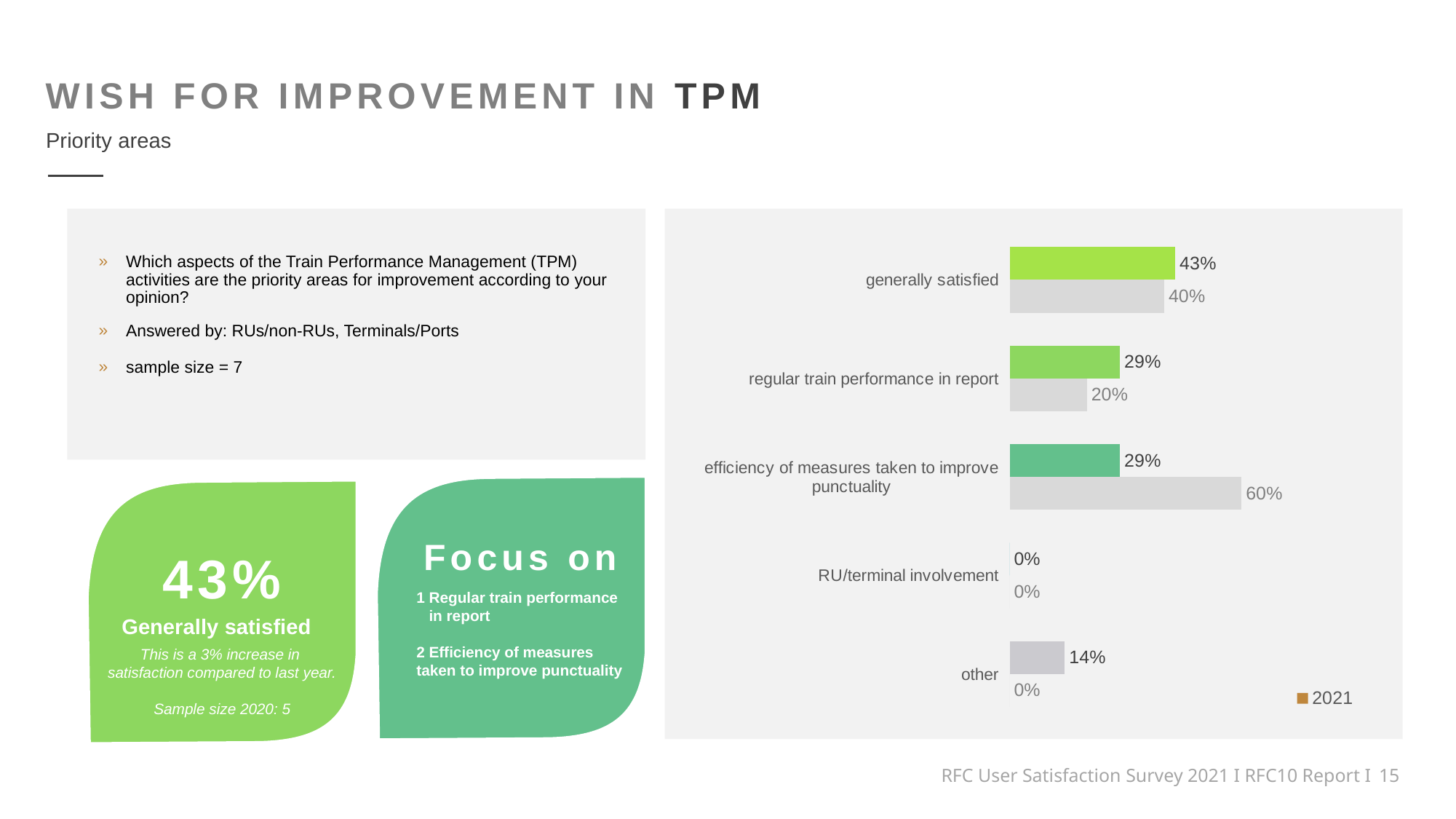
Which series name is shown in the chart's legend? 2021 What is the 2021 value for 'generally satisfied' in the chart? 43% What is the difference between the 2021 value and the lower grey bar value for 'regular train performance in report'? 9% For 'efficiency of measures taken to improve punctuality', which is larger: the 2021 bar or the lower grey bar? the lower grey bar Which category has the lowest 2021 value? RU/terminal involvement What kind of chart is shown on the right of the slide? bar chart What is the 2021 value for 'regular train performance in report'? 29% How many categories are listed on the chart's vertical axis? 5 What is the 2021 value for 'other'? 14% What is the difference between the 2021 values for 'generally satisfied' and 'other'? 29% Which category has the highest 2021 value? generally satisfied What is the value of the lower grey bar for 'efficiency of measures taken to improve punctuality'? 60%